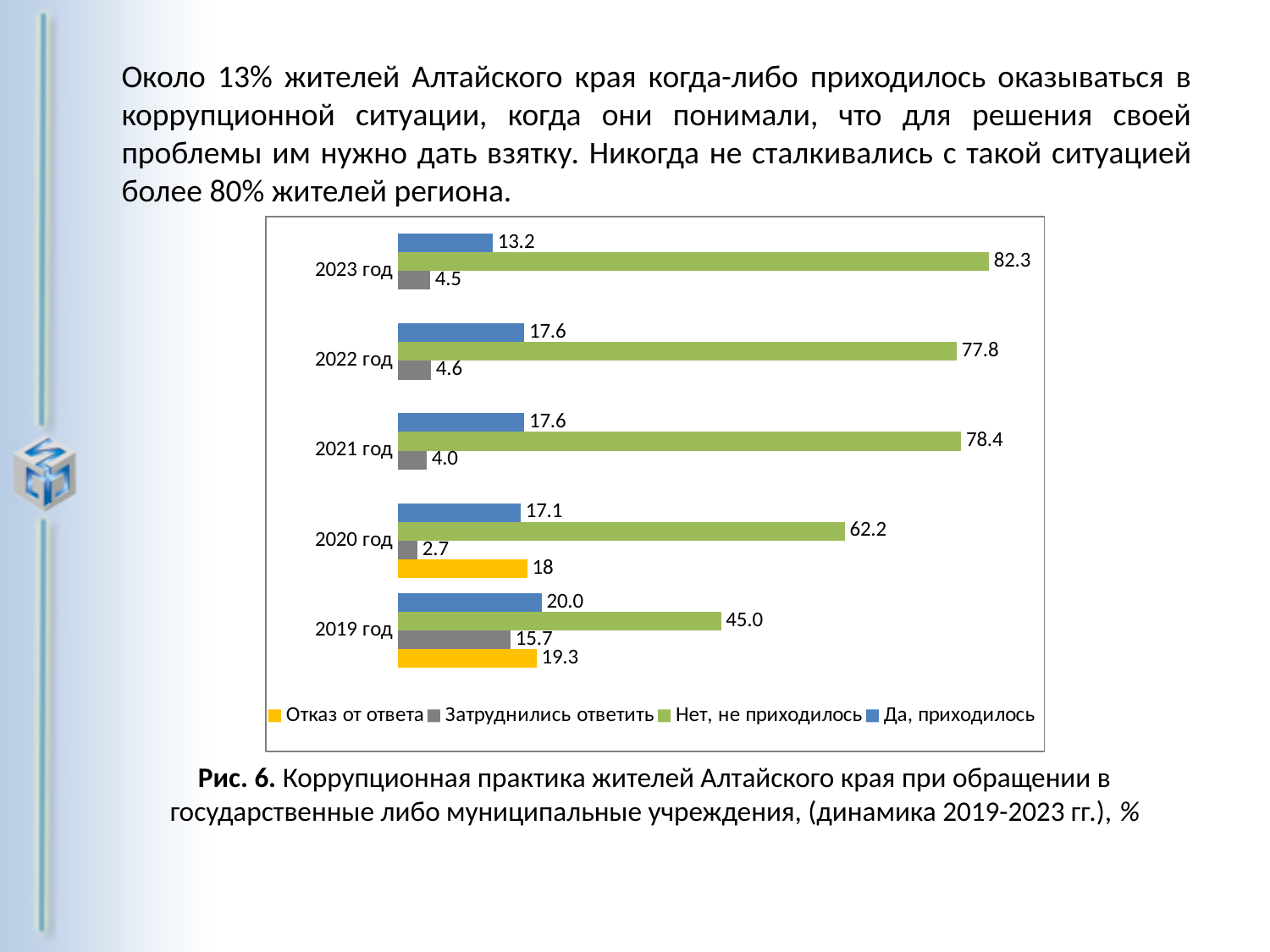
What kind of chart is shown on the slide? Bar chart Which colour represents "Отказ от ответа" in the chart? Yellow Which is larger: the "Да, приходилось" value for 2019 год or for 2020 год? 2019 год What is the value for "Да, приходилось" in 2023 год? 13.2 What is the value for "Затруднились ответить" in 2020 год? 2.7 In which year is the value for "Да, приходилось" the lowest? 2023 год How many years are shown on the chart? 5 What is the value for "Нет, не приходилось" in 2019 год? 45.0 What is the value for "Отказ от ответа" in 2019 год? 19.3 What is the difference between the "Нет, не приходилось" values for 2023 год and 2022 год? 4.5 In which year is the value for "Нет, не приходилось" the highest? 2023 год How many series does the legend list? 4